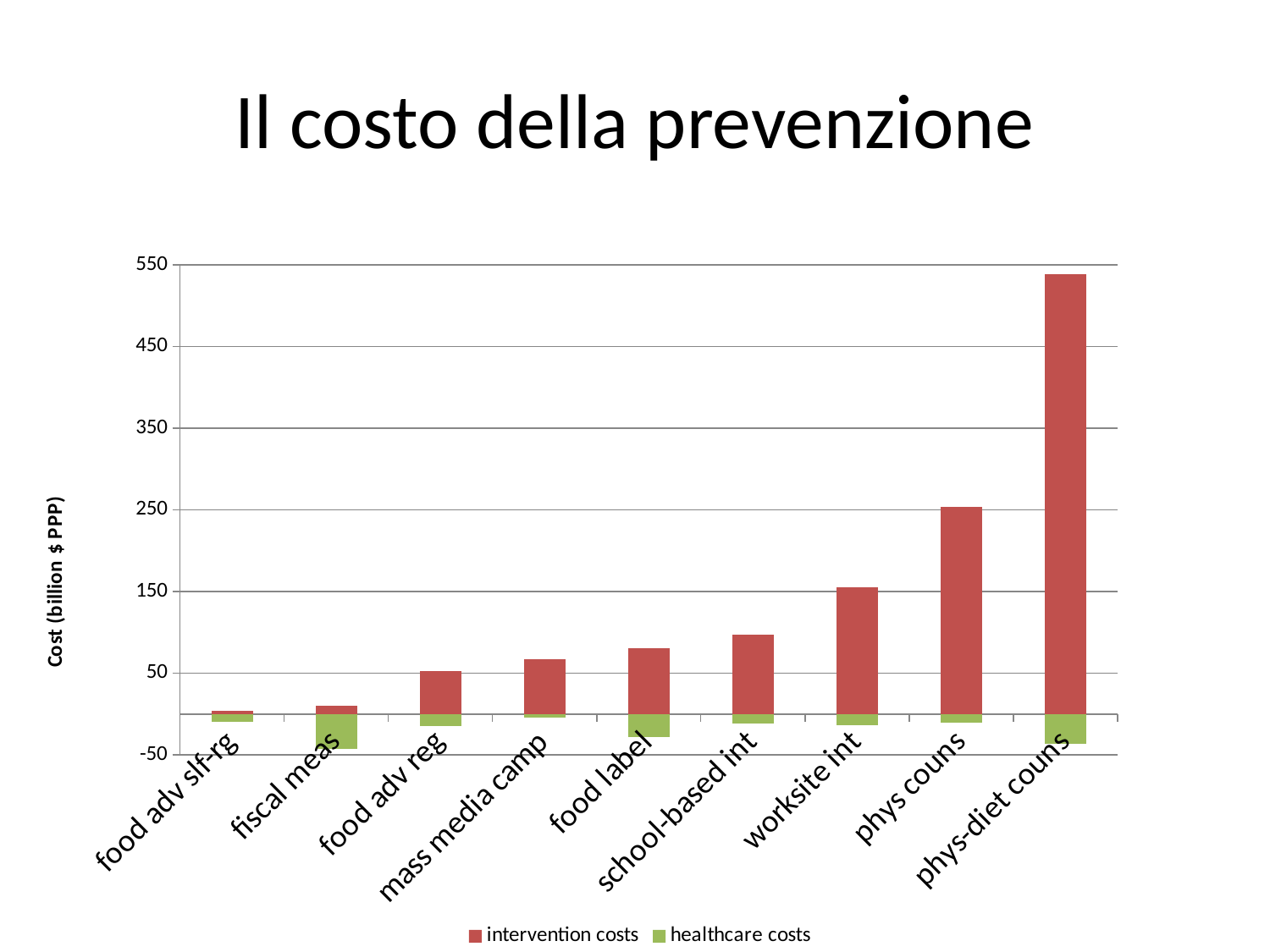
Which category has the highest intervention costs? phys-diet couns How many series does the chart's legend list? 2 Is the intervention costs value for phys-diet couns greater or less than 450? greater Is the intervention costs value for school-based int greater or less than 150? less Do the intervention costs rise or fall moving left to right along the x axis? rise What is the label of the chart's vertical axis? Cost (billion $ PPP) How many categories are shown on the x axis of the chart? 9 Is the intervention costs value for phys couns greater or less than 150? greater Which category has the lowest intervention costs? food adv slf-rg Which has larger intervention costs, phys couns or worksite int? phys couns What kind of chart is shown on the slide? bar chart